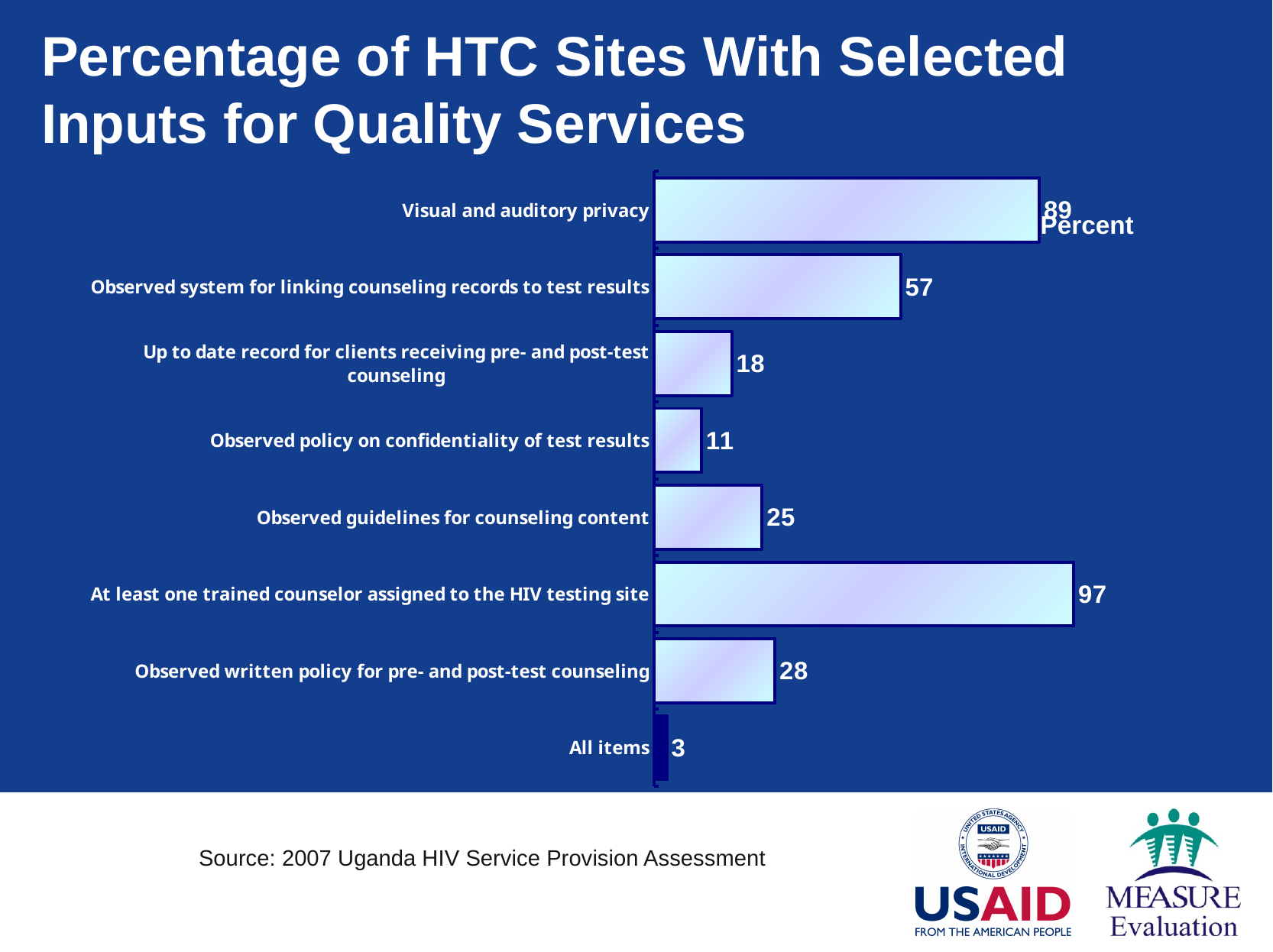
Which is larger: the value for 'Observed guidelines for counseling content' or 'Up to date record for clients receiving pre- and post-test counseling'? Observed guidelines for counseling content Which category has the lowest value? All items Which category has the highest value? At least one trained counselor assigned to the HIV testing site What is the difference between the values for 'Observed written policy for pre- and post-test counseling' and 'Observed policy on confidentiality of test results'? 17 What is the source cited for the chart data? 2007 Uganda HIV Service Provision Assessment What is the value for 'Observed system for linking counseling records to test results'? 57 What is the value for 'All items'? 3 What kind of chart is shown on the slide? Bar chart What percentage of HTC sites have visual and auditory privacy? 89 What is the value for 'Observed written policy for pre- and post-test counseling'? 28 How many categories are shown in the chart? 8 What is the difference between the values for 'At least one trained counselor assigned to the HIV testing site' and 'Visual and auditory privacy'? 8